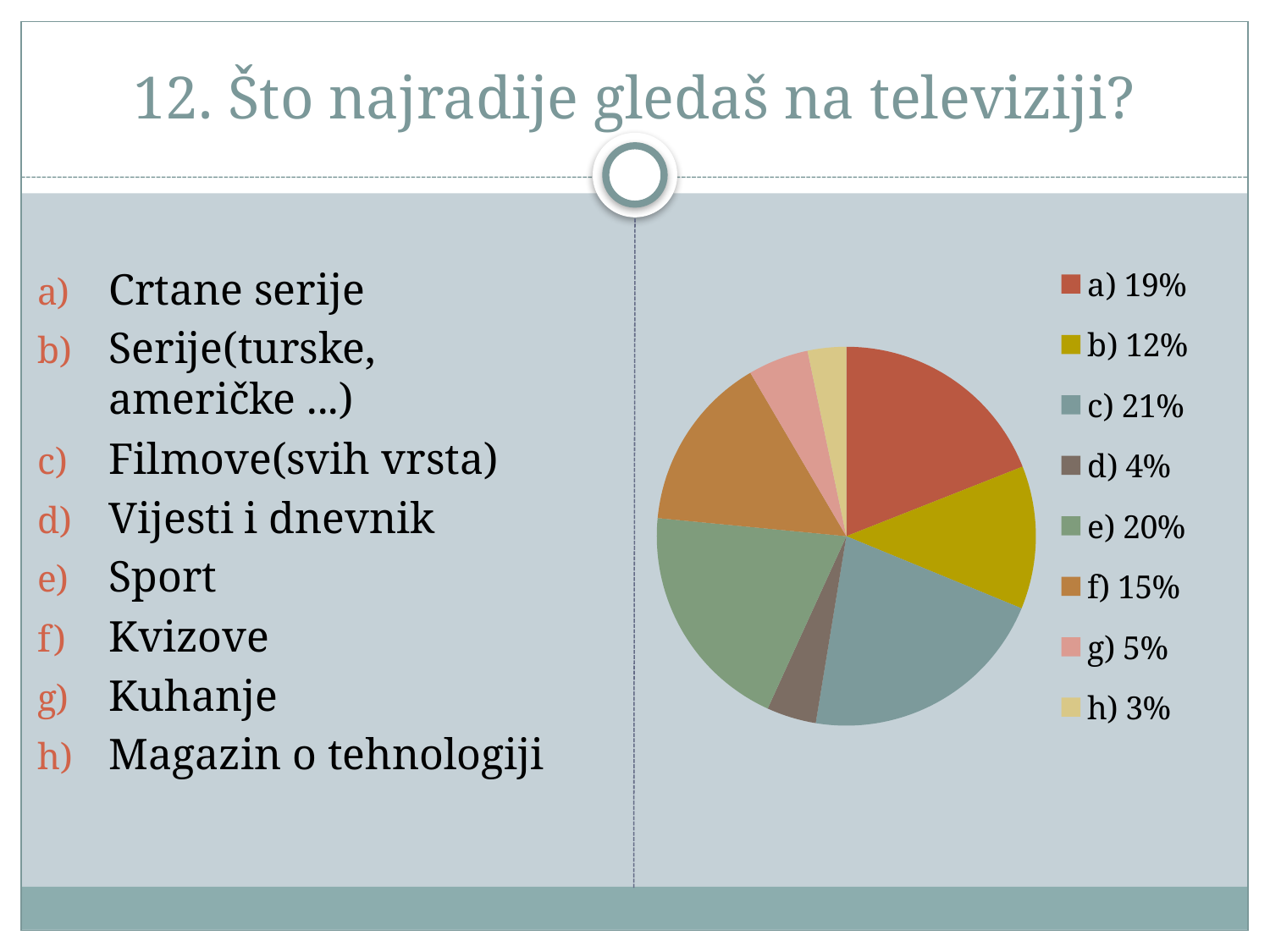
What colour is the slice for a) in the pie chart? red Which slice has the smallest share of the pie? h) 3% What percentage does the legend show for slice c)? 21% What is the combined share of slices g) and h)? 8% What percentage does the legend show for slice f)? 15% Which is larger, slice e) or slice f)? e) Which slice has the largest share of the pie? c) 21% How many slices does the pie chart have? 8 What percentage does the legend show for slice d)? 4% What is the difference in percentage points between slice a) and slice b)? 7 How many entries does the legend list? 8 What kind of chart is shown on the slide? pie chart